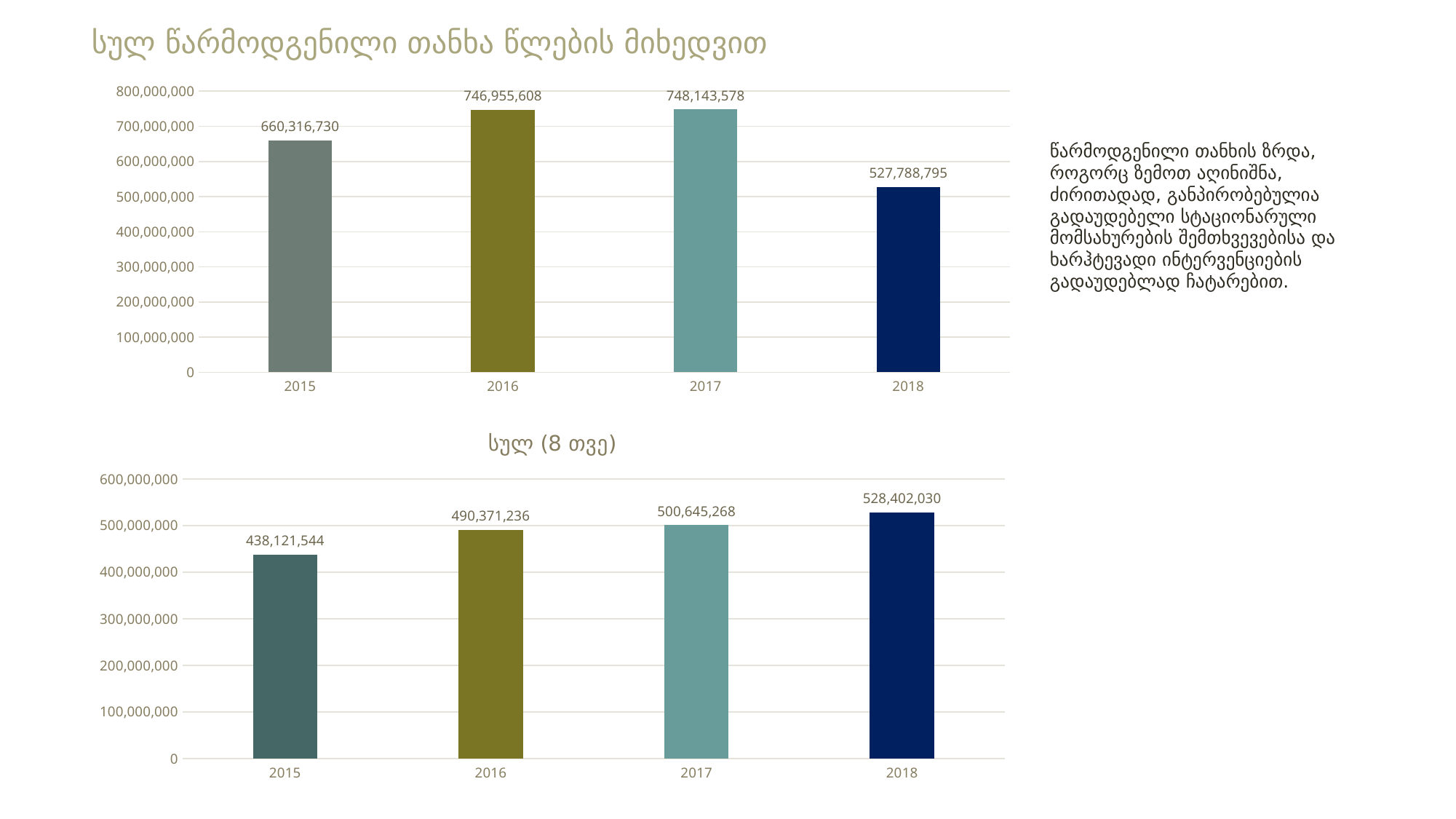
In the top chart, what is the value for 2015? 660,316,730 What kind of chart is the bottom chart (სულ (8 თვე))? bar chart In the bottom chart (სულ (8 თვე)), which year has the lowest value? 2015 In the top chart, which is larger: the value for 2015 or the value for 2018? 2015 How many years are shown in the top chart? 4 In the top chart, what is the difference between the values for 2016 and 2015? 86,638,878 In the top chart, what is the value for 2018? 527,788,795 In the top chart, which year has the lowest value? 2018 In the bottom chart (სულ (8 თვე)), do the values rise or fall from 2015 to 2018? rise In the bottom chart (სულ (8 თვე)), which year has the highest value? 2018 In the bottom chart (სულ (8 თვე)), what is the difference between the values for 2018 and 2015? 90,280,486 In the bottom chart (სულ (8 თვე)), what is the value for 2017? 500,645,268